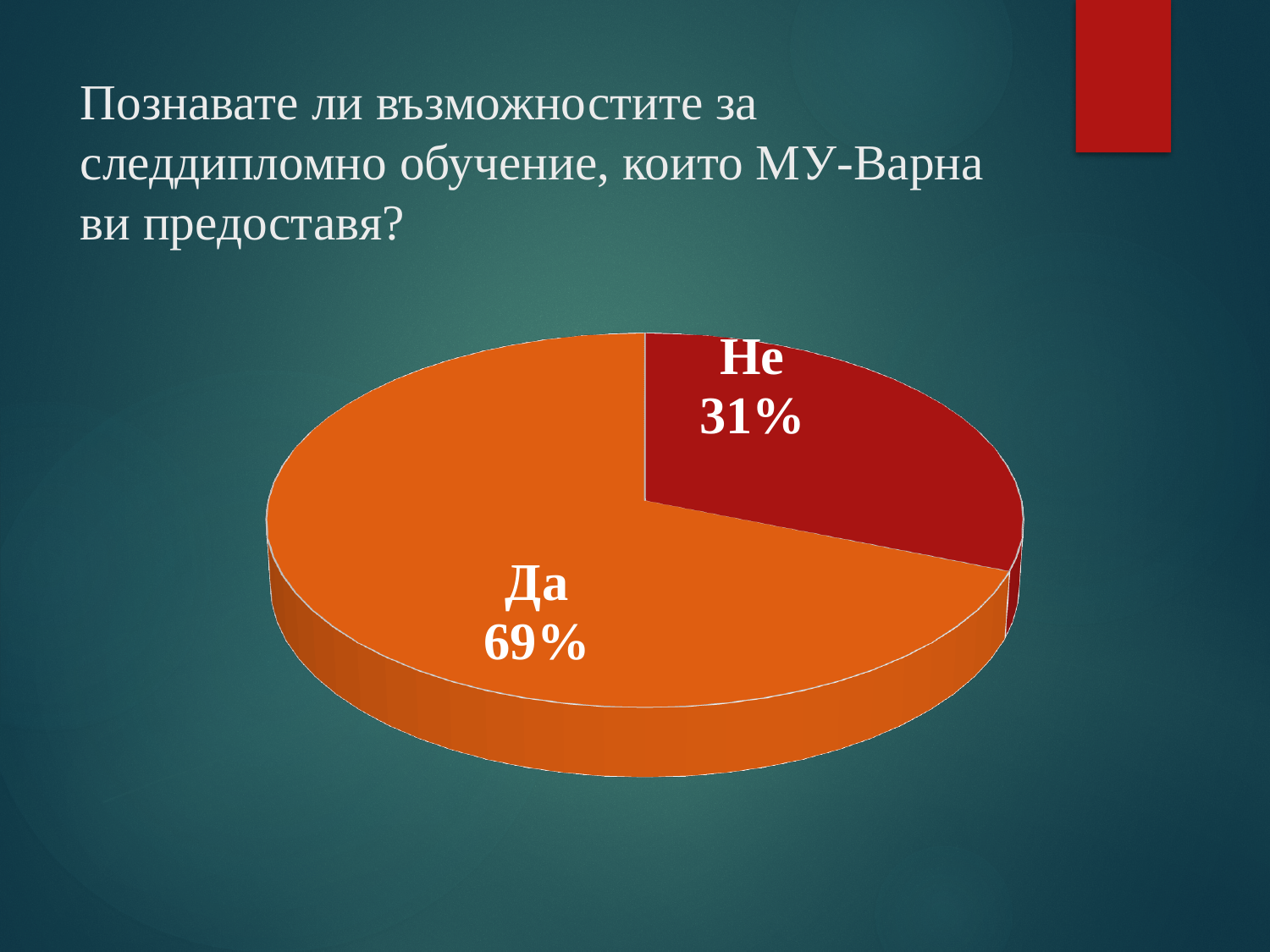
What colour is the "Не" slice? Red Which slice of the pie is the smallest? Не What is the difference in percentage points between the "Да" and "Не" slices? 38 How many slices does the pie chart have? 2 What share of the pie does the "Да" slice represent? 69% Which is larger, the "Да" slice or the "Не" slice? Да Which slice of the pie is the largest? Да What colour is the "Да" slice? Orange What kind of chart is shown on the slide? Pie chart What share of the pie does the "Не" slice represent? 31%